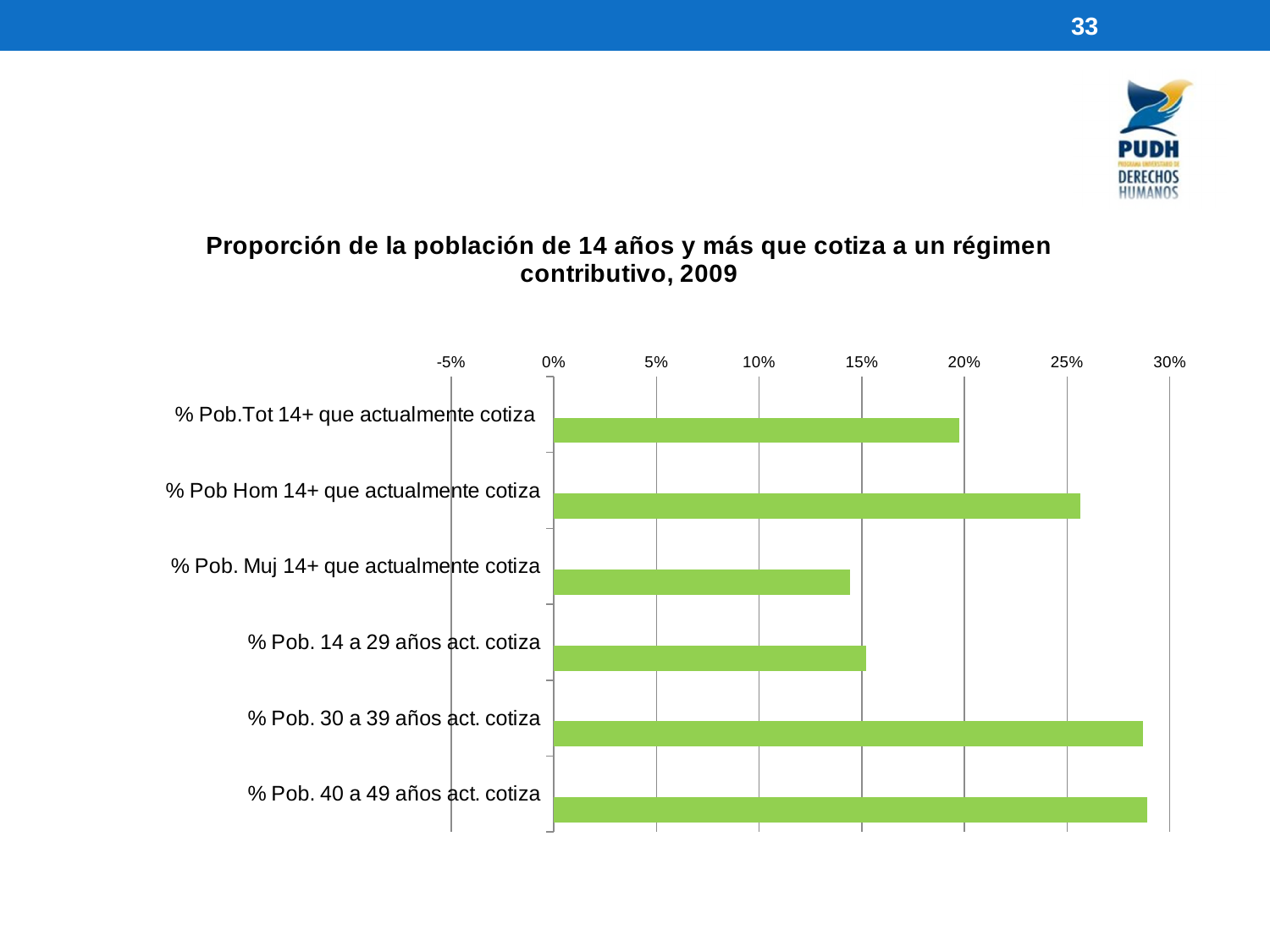
What kind of chart is shown on the slide? bar chart Which is larger: the value for '% Pob Hom 14+ que actualmente cotiza' or '% Pob. Muj 14+ que actualmente cotiza'? % Pob Hom 14+ que actualmente cotiza Is the value for '% Pob Hom 14+ que actualmente cotiza' greater or less than 20%? greater What colour are the bars in the chart? green Is the value for '% Pob. 40 a 49 años act. cotiza' greater or less than 25%? greater How many categories (bars) does the chart show? 6 Is the value for '% Pob.Tot 14+ que actualmente cotiza' greater or less than 15%? greater What is the title of the chart? Proporción de la población de 14 años y más que cotiza a un régimen contributivo, 2009 Which is larger: the value for '% Pob. 30 a 39 años act. cotiza' or '% Pob. 14 a 29 años act. cotiza'? % Pob. 30 a 39 años act. cotiza